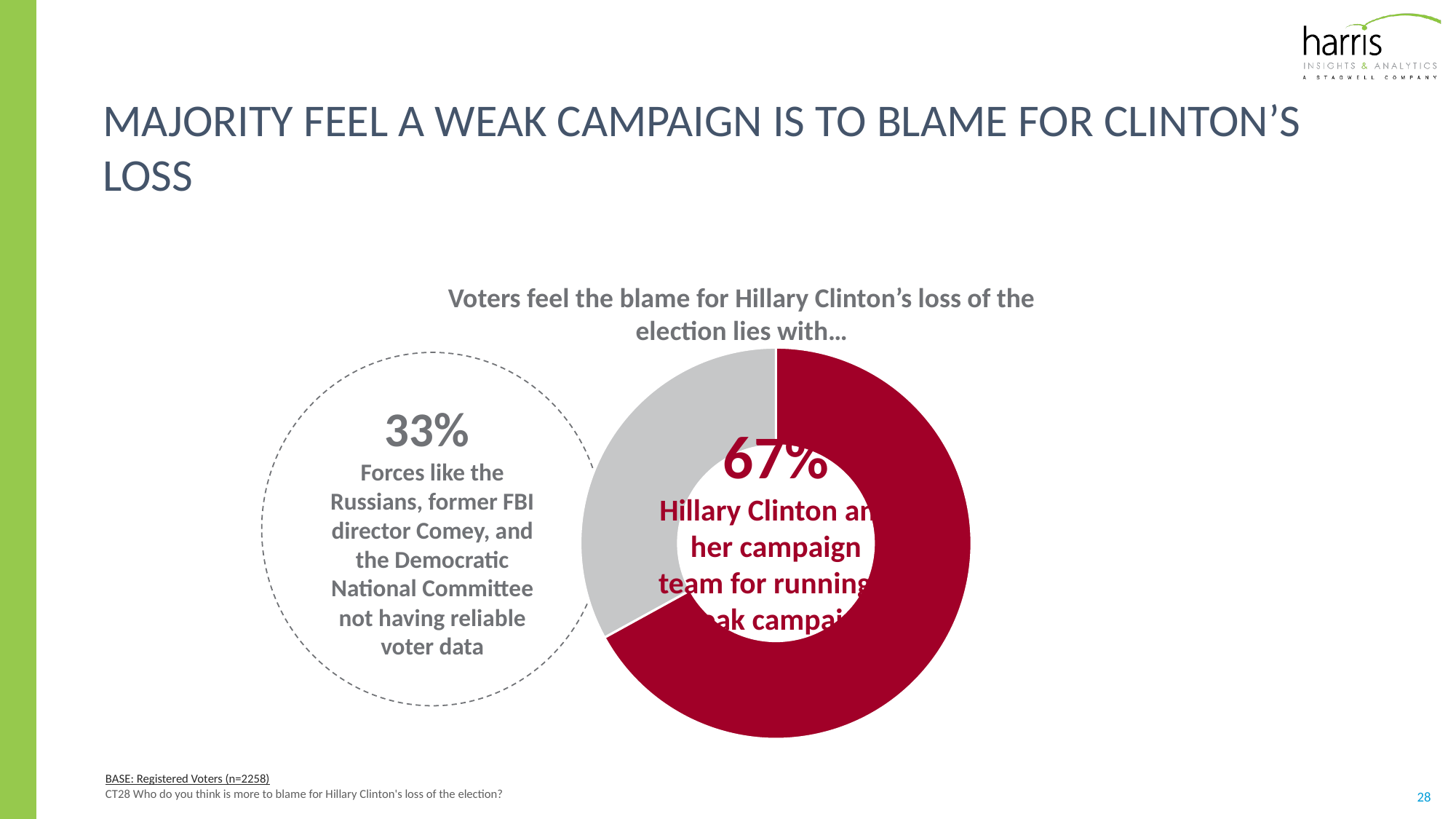
What share of voters blame forces like the Russians, former FBI director Comey, and the Democratic National Committee not having reliable voter data? 33% Which option has the larger share: Hillary Clinton and her campaign team, or forces like the Russians, Comey and the DNC? Hillary Clinton and her campaign team Which slice of the chart is the smallest? Forces like the Russians, former FBI director Comey, and the Democratic National Committee not having reliable voter data What share of voters blame Hillary Clinton and her campaign team for running a weak campaign? 67% What is the title of the chart? Voters feel the blame for Hillary Clinton's loss of the election lies with… What kind of chart is shown on the slide? Pie chart (doughnut) What is the difference in percentage points between the two slices of the chart? 34 percentage points What is the total of the two slices shown in the chart? 100% Is the share blaming Hillary Clinton and her campaign team greater or less than 50%? greater What colour is the slice representing Hillary Clinton and her campaign team? Red How many slices does the chart have? 2